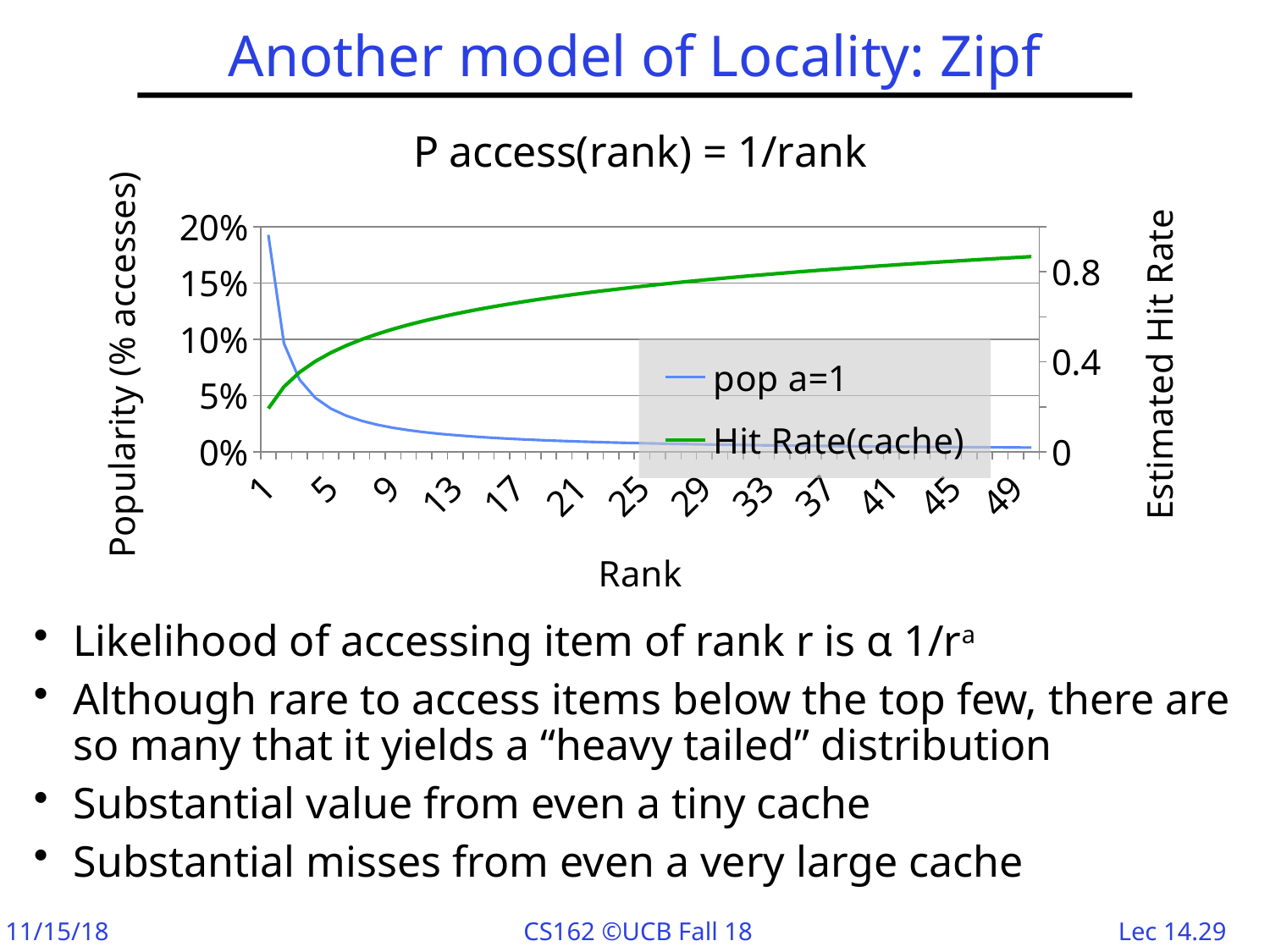
Is the Hit Rate(cache) value at rank 49 greater or less than 0.8? greater Does the pop a=1 series rise or fall as rank increases along the x axis? fall Does the Hit Rate(cache) series rise or fall as rank increases along the x axis? rise Is the pop a=1 value at rank 25 greater or less than 5%? less How many series does the chart legend list? 2 What kind of chart is shown on the slide? line chart What is the title of the chart? P access(rank) = 1/rank Is the Hit Rate(cache) value at rank 1 greater or less than 0.4? less What are the two series named in the chart legend? pop a=1 and Hit Rate(cache)